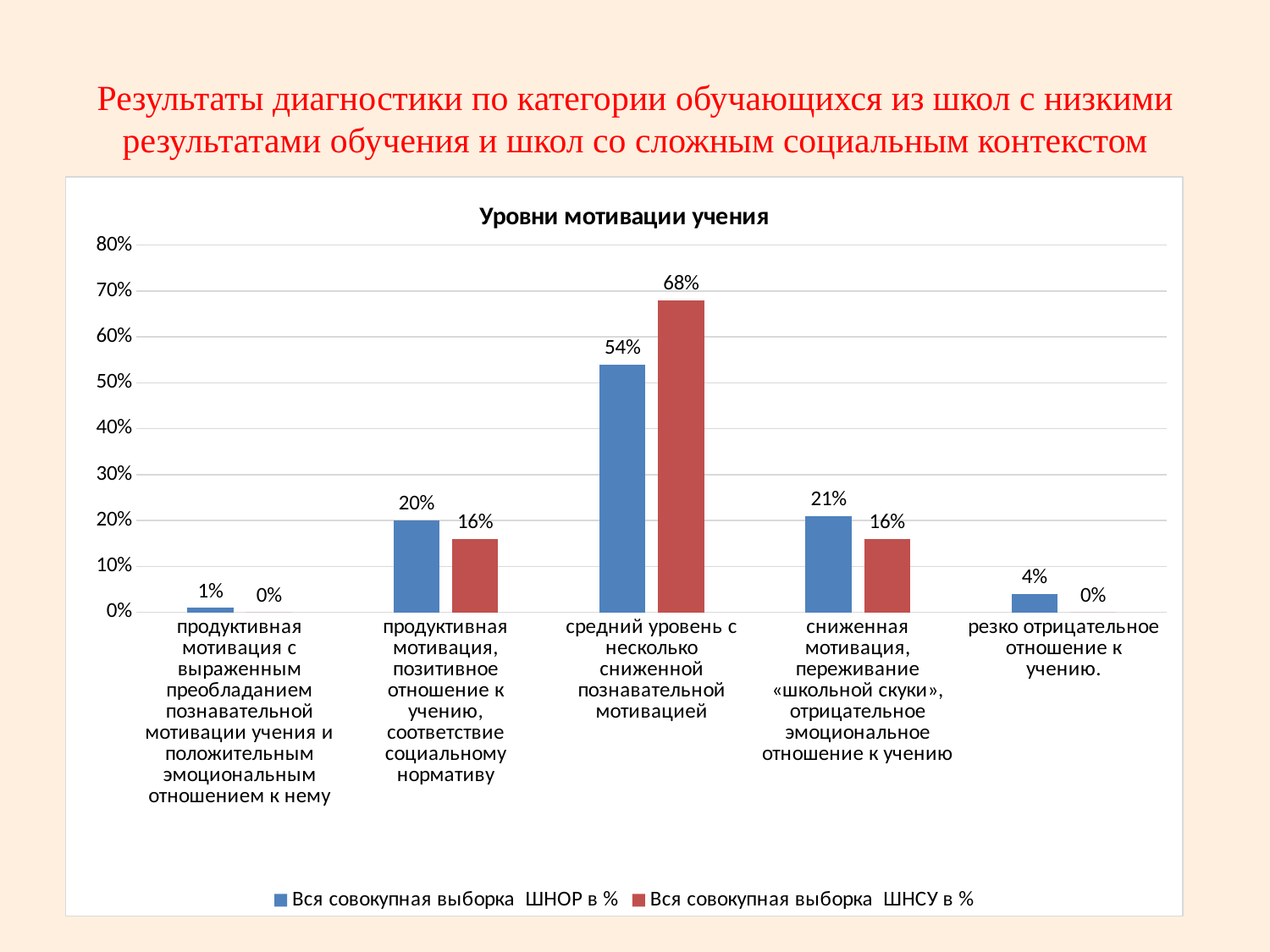
Which category has the lowest value for the ШНОР series? продуктивная мотивация с выраженным преобладанием познавательной мотивации учения и положительным эмоциональным отношением к нему What type of chart is shown on the slide? bar chart What is the ШНСУ value for the category "резко отрицательное отношение к учению"? 0% How many categories are shown on the x axis of the chart? 5 Is the ШНОР value for "средний уровень с несколько сниженной познавательной мотивацией" greater or less than 50%? greater What is the value for ШНОР (blue series) in the category "средний уровень с несколько сниженной познавательной мотивацией"? 54% What is the value for ШНСУ (red series) in the category "средний уровень с несколько сниженной познавательной мотивацией"? 68% Which category has the highest value for the ШНСУ series? средний уровень с несколько сниженной познавательной мотивацией In the category "продуктивная мотивация, позитивное отношение к учению, соответствие социальному нормативу", which series has the larger value, ШНОР or ШНСУ? ШНОР What is the difference between the ШНСУ and ШНОР values in the category "средний уровень с несколько сниженной познавательной мотивацией"? 14% What is the ШНОР value for the category "сниженная мотивация, переживание «школьной скуки», отрицательное эмоциональное отношение к учению"? 21% How many series does the chart legend list? 2